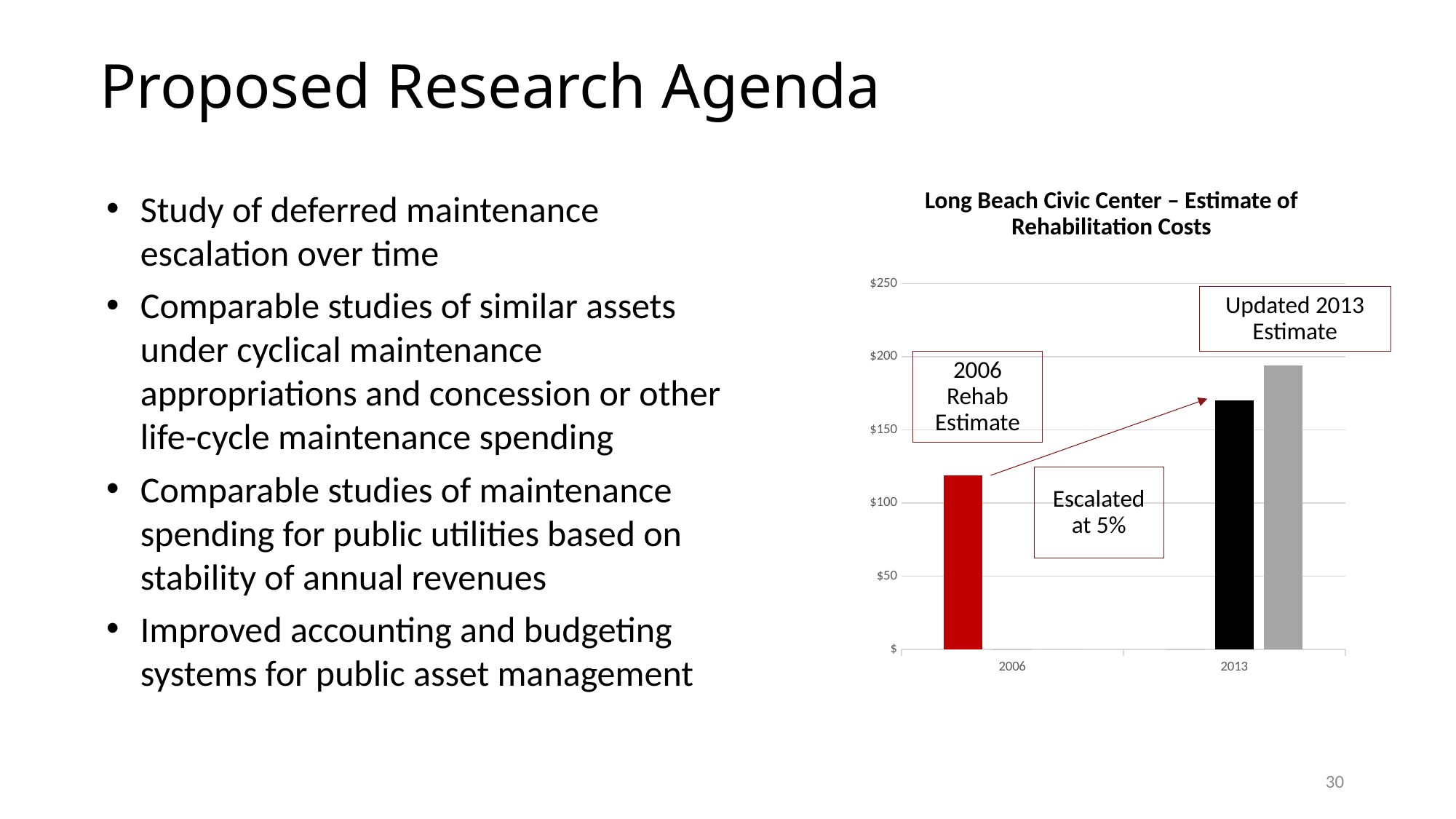
What is the title of the chart? Long Beach Civic Center – Estimate of Rehabilitation Costs Is the value of the gray bar for 2013 greater or less than $150? greater Which bar in the chart is the tallest? the gray bar for 2013 What kind of chart is shown on the slide? bar chart According to the annotation on the chart, at what rate was the 2006 estimate escalated? 5% How many years are shown on the x axis of the chart? 2 Do the estimated rehabilitation costs rise or fall from 2006 to 2013? rise Is the value of the gray bar for 2013 greater or less than $200? less Is the value of the red bar for 2006 greater or less than $150? less Which is larger, the red bar for 2006 or the black bar for 2013? the black bar for 2013